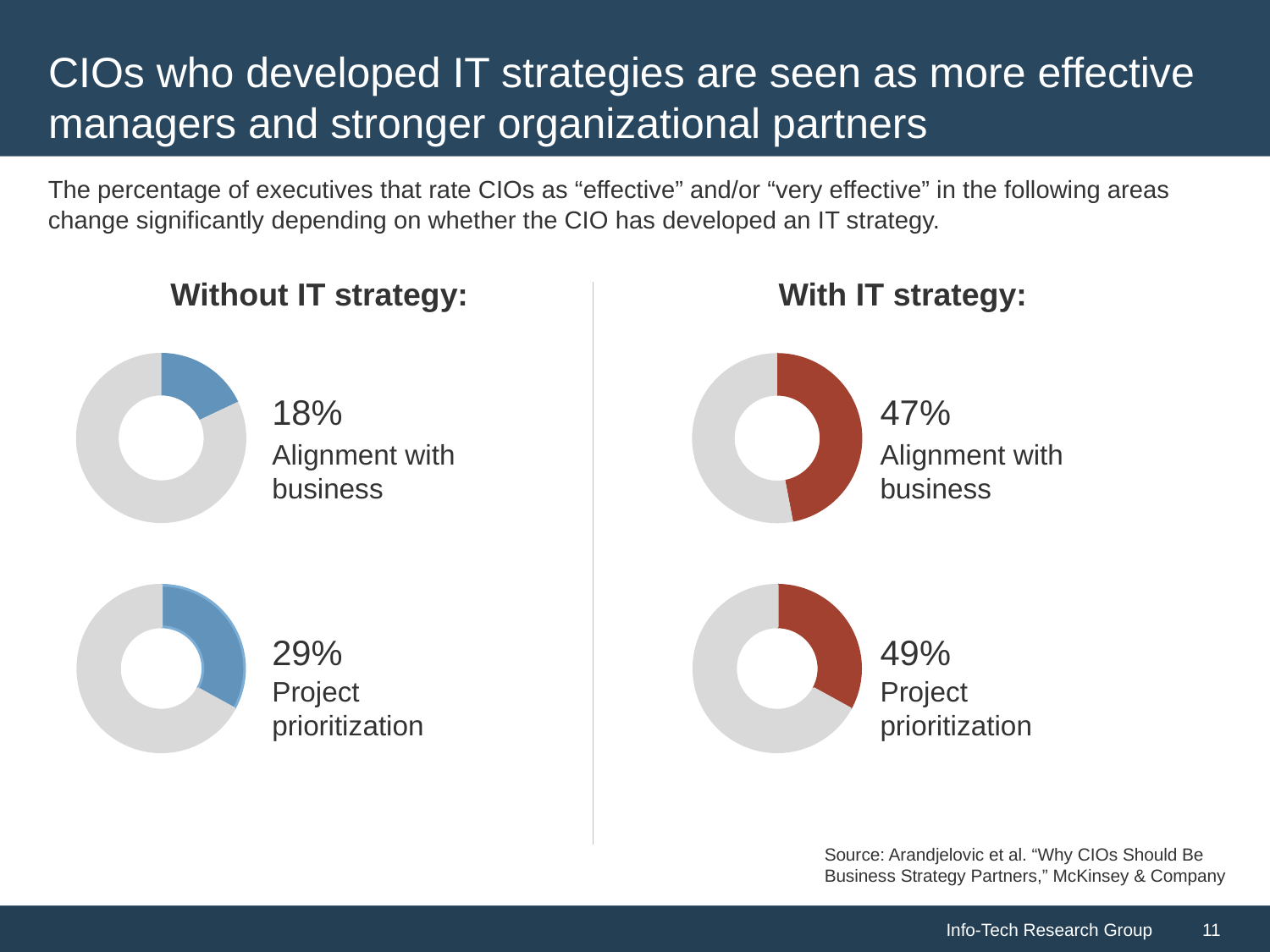
What kind of chart is used to display each percentage on the slide? Donut (pie) chart On the 'Without IT strategy' side, what percentage is shown for Alignment with business? 18% Which of the four percentages shown on the slide is the highest? 49% (Project prioritization, with IT strategy) How many donut charts are shown on the slide? 4 What is the difference between the Alignment with business percentages with and without an IT strategy? 29% What is the difference between the Project prioritization percentages with and without an IT strategy? 20% On the 'With IT strategy' side, what percentage is shown for Project prioritization? 49% Which of the four percentages shown on the slide is the lowest? 18% (Alignment with business, without IT strategy) On the 'With IT strategy' side, what percentage is shown for Alignment with business? 47% Which is larger: the Alignment with business percentage without an IT strategy or with an IT strategy? With IT strategy What colour is the highlighted segment in the 'With IT strategy' donut charts? Red On the 'Without IT strategy' side, what percentage is shown for Project prioritization? 29%